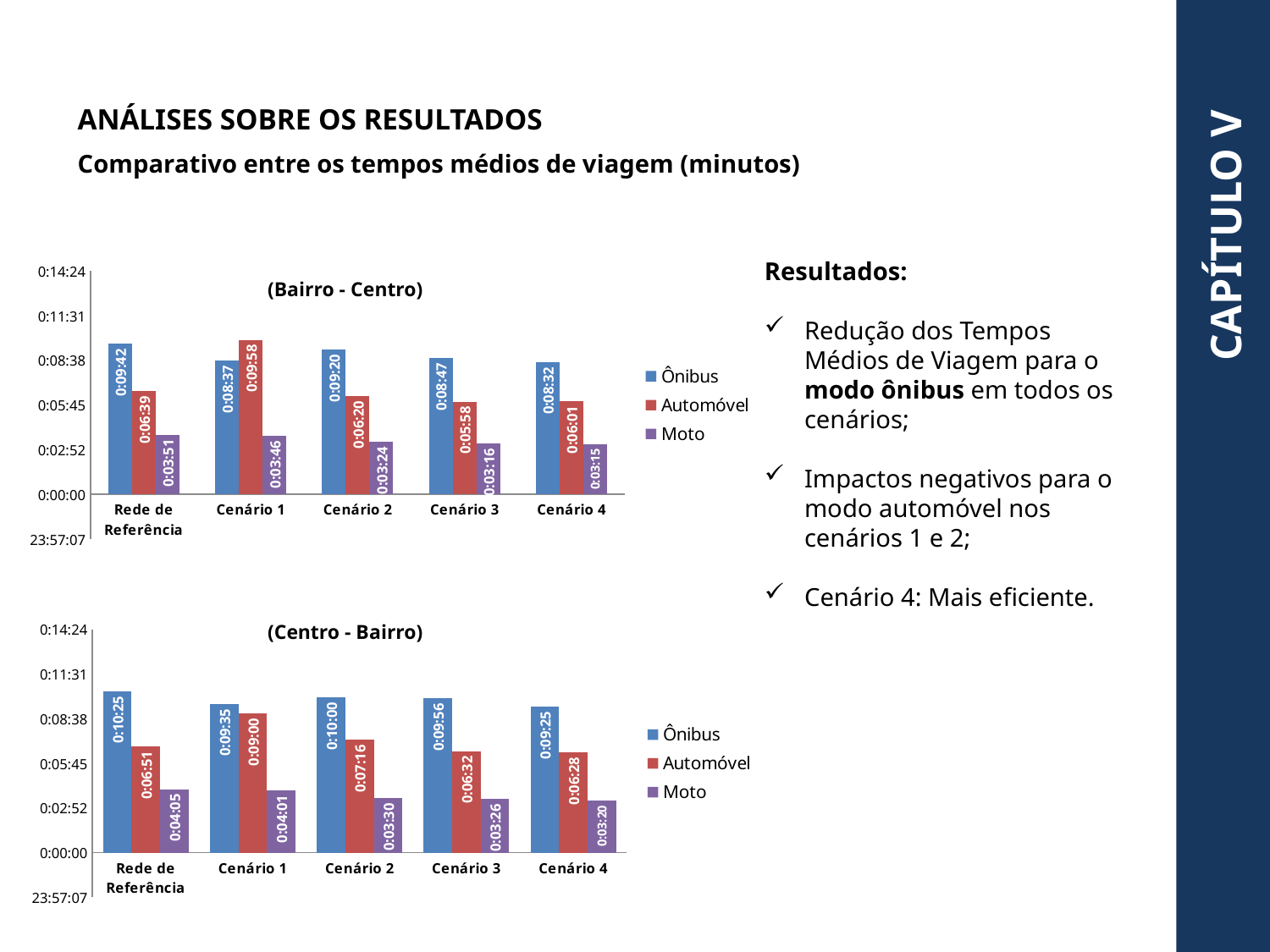
In the (Bairro - Centro) chart, is the Moto value for Cenário 2 greater or less than 0:05:45? less How many categories are shown on the x axis of the (Centro - Bairro) chart? 5 How many series does the legend of the (Bairro - Centro) chart list? 3 In the (Centro - Bairro) chart, what is the value for Moto in Cenário 4? 0:03:20 In the (Bairro - Centro) chart, what is the value for Automóvel in Rede de Referência? 0:06:39 In the (Centro - Bairro) chart, which category has the lowest Moto value? Cenário 4 In the (Bairro - Centro) chart, which category has the highest Automóvel value? Cenário 1 In the (Bairro - Centro) chart, what is the difference between the Ônibus values for Rede de Referência and Cenário 4? 0:01:10 In the (Centro - Bairro) chart, which is larger in Cenário 1: the Ônibus value or the Automóvel value? Ônibus What type of chart is the (Centro - Bairro) chart? Bar chart In the (Centro - Bairro) chart, what is the value for Automóvel in Cenário 2? 0:07:16 In the (Bairro - Centro) chart, what is the value for Ônibus in Cenário 1? 0:08:37